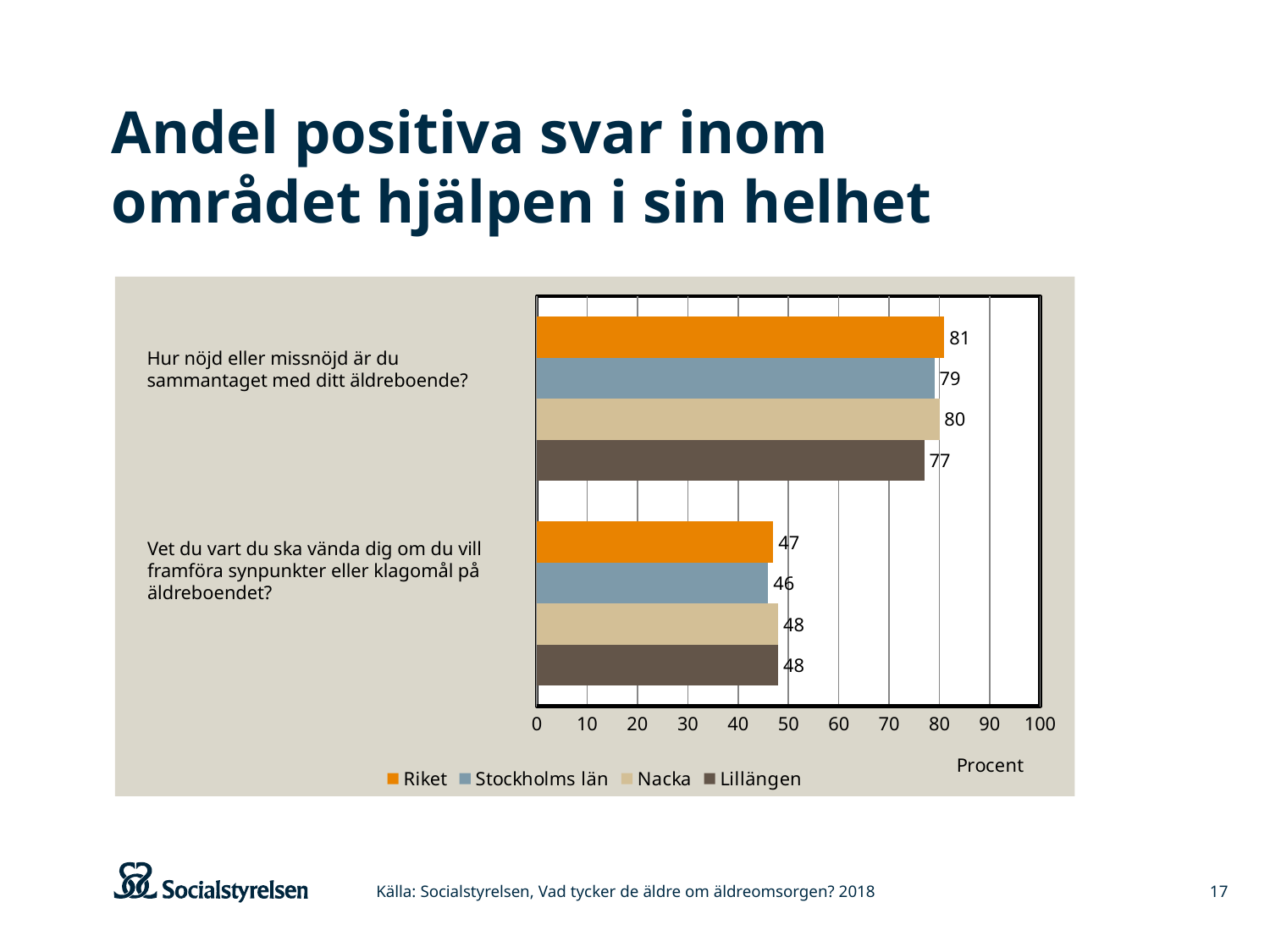
What kind of chart is shown on the slide? Bar chart What is the value for Lillängen on the question "Hur nöjd eller missnöjd är du sammantaget med ditt äldreboende?"? 77 What unit is shown on the x axis of the chart? Procent What is the value for Stockholms län on the question "Vet du vart du ska vända dig om du vill framföra synpunkter eller klagomål på äldreboendet?"? 46 What is the value for Riket on the question "Hur nöjd eller missnöjd är du sammantaget med ditt äldreboende?"? 81 Which series has the lowest value for "Vet du vart du ska vända dig om du vill framföra synpunkter eller klagomål på äldreboendet?"? Stockholms län What is the difference between the Riket and Lillängen values for "Hur nöjd eller missnöjd är du sammantaget med ditt äldreboende?"? 4 What is the value for Nacka on the question "Vet du vart du ska vända dig om du vill framföra synpunkter eller klagomål på äldreboendet?"? 48 How many questions (categories) are shown on the chart? 2 For Riket, which question has the larger value: "Hur nöjd eller missnöjd är du sammantaget med ditt äldreboende?" or "Vet du vart du ska vända dig om du vill framföra synpunkter eller klagomål på äldreboendet?"? Hur nöjd eller missnöjd är du sammantaget med ditt äldreboende? Which series has the highest value for "Hur nöjd eller missnöjd är du sammantaget med ditt äldreboende?"? Riket How many series does the legend list? 4